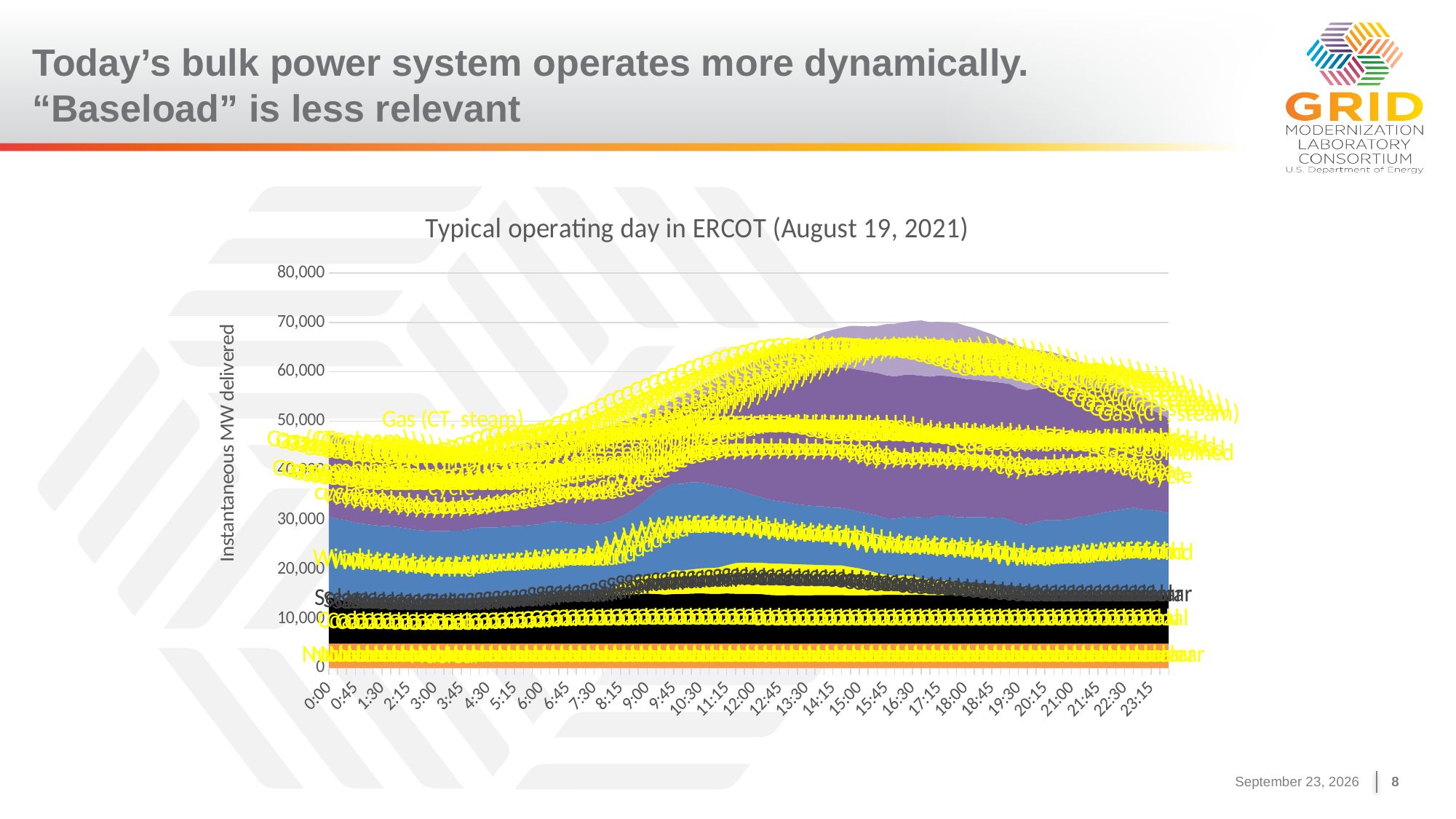
Does the total MW delivered rise or fall between 6:00 and 16:30? rise Is the total MW delivered at 0:00 greater or less than 50,000? less Does the total MW delivered rise or fall between 17:15 and 23:15? fall Is the total MW delivered at 16:30 larger or smaller than at 3:00? larger What is the title of the chart? Typical operating day in ERCOT (August 19, 2021) What is the last time label on the horizontal axis? 23:15 What is the highest value shown on the vertical axis? 80,000 How many time labels are shown on the horizontal axis? 32 What type of chart is shown on the slide? Stacked area chart What is the first time label on the horizontal axis? 0:00 What is the label on the vertical axis of the chart? Instantaneous MW delivered Is the total MW delivered at 16:30 greater or less than 60,000? greater